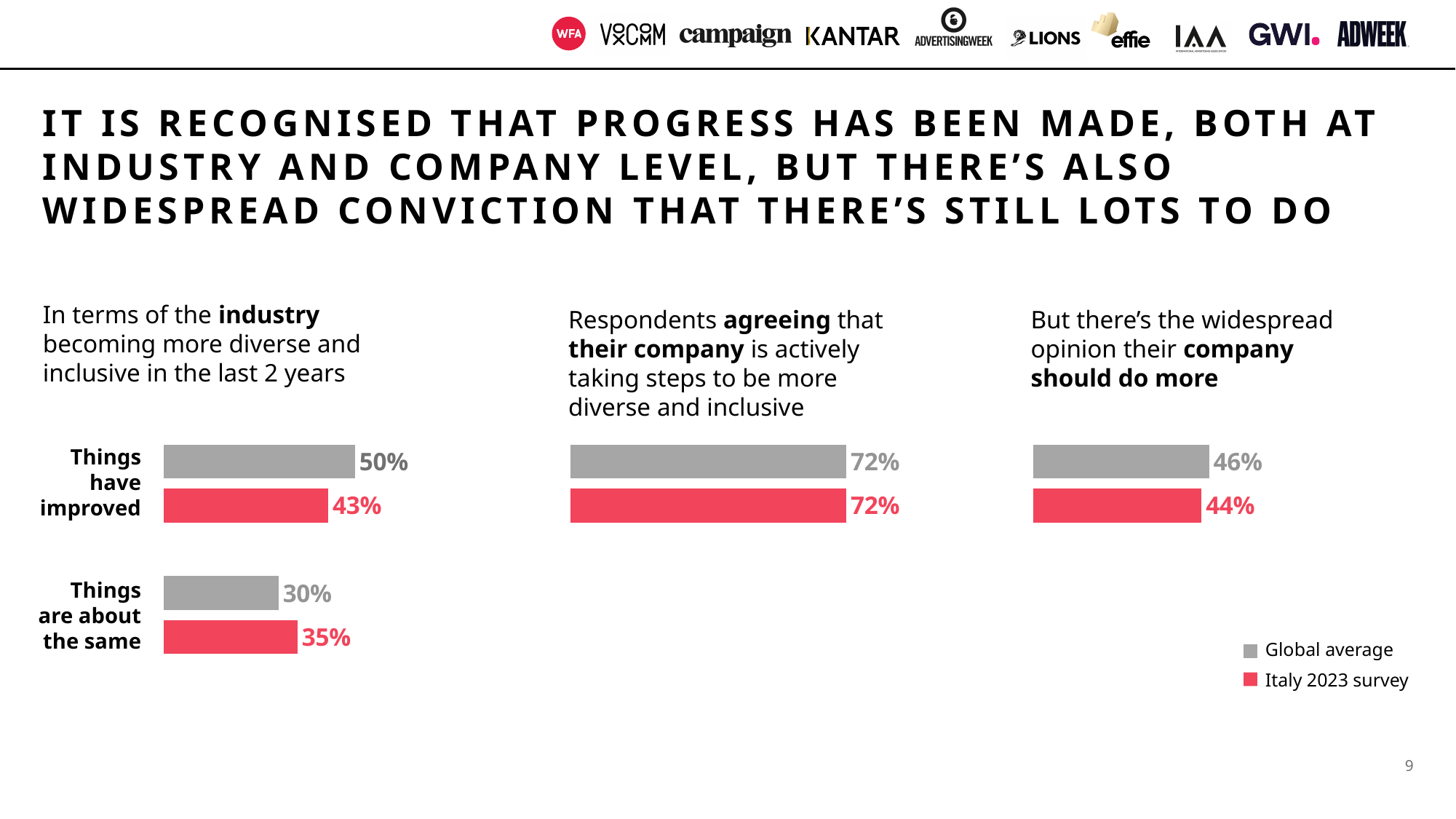
In the left chart about the industry becoming more diverse and inclusive, which is larger for 'Things are about the same': the Global average or the Italy 2023 survey? Italy 2023 survey In the right chart about the opinion that their company should do more, what is the Italy 2023 survey value? 44% In the middle chart about respondents agreeing their company is actively taking steps, what is the Italy 2023 survey value? 72% In the right chart about the opinion that their company should do more, which is larger: the Global average or the Italy 2023 survey? Global average What kind of chart is the left chart about the industry becoming more diverse and inclusive? Bar chart In the left chart about the industry becoming more diverse and inclusive, how many categories are shown? 2 In the middle chart about respondents agreeing their company is actively taking steps, what is the difference between the Global average and the Italy 2023 survey values? 0% In the left chart about the industry becoming more diverse and inclusive, what is the difference between the Global average and Italy 2023 survey values for 'Things have improved'? 7% In the left chart about the industry becoming more diverse and inclusive, what is the Italy 2023 survey value for 'Things are about the same'? 35% How many series does the legend list? 2 In the right chart about the opinion that their company should do more, what is the Global average value? 46% In the left chart about the industry becoming more diverse and inclusive, what is the Global average value for 'Things have improved'? 50%